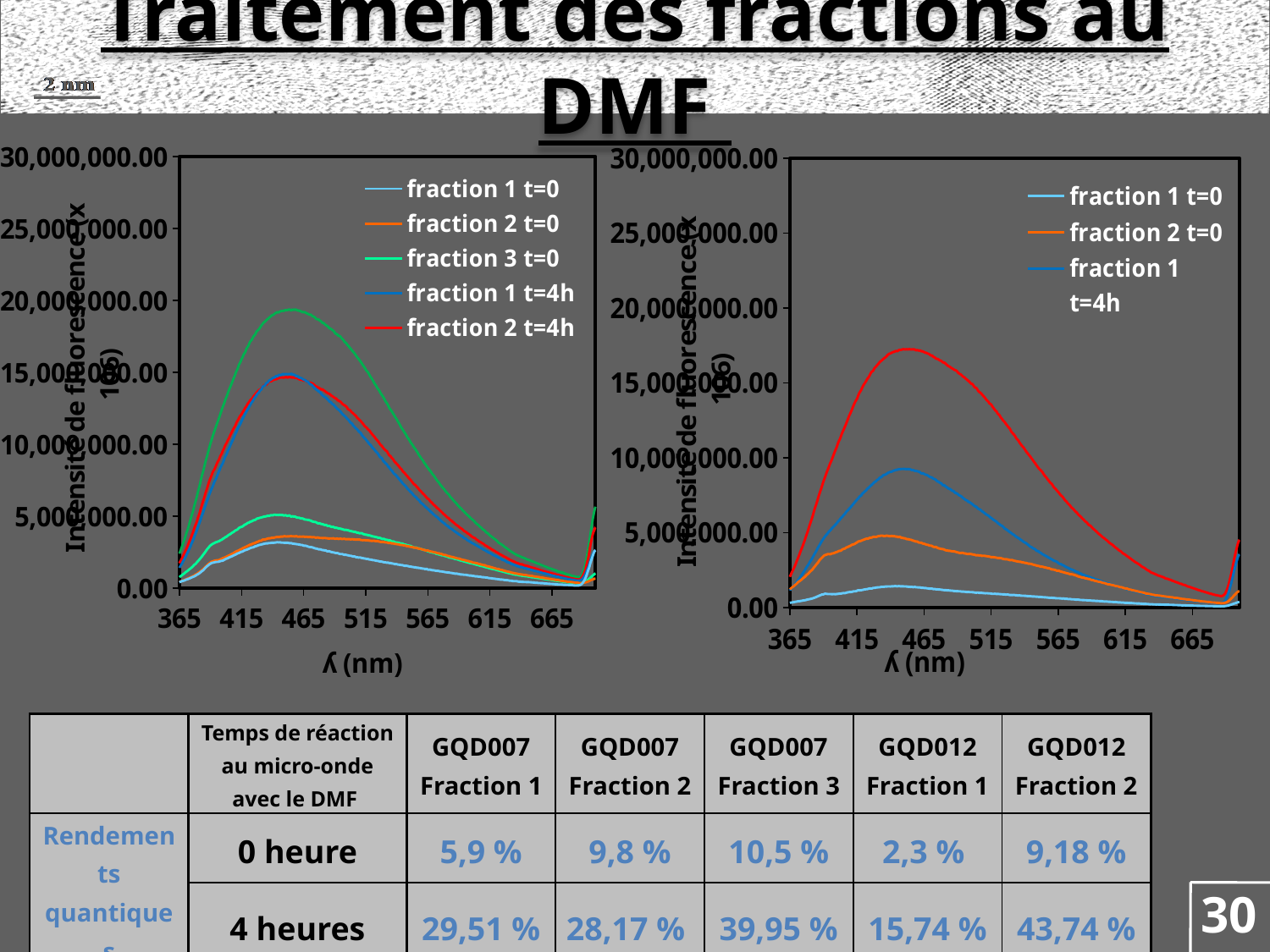
In the right chart, which of the legend series has the lowest peak intensity? fraction 1 t=0 How many series does the legend of the right chart list? 3 In the left chart, is the peak value of fraction 1 t=0 greater or less than 5,000,000.00? less In the right chart, is the peak value of fraction 1 t=4h greater or less than 10,000,000.00? less What is the x-axis label of the left chart? ʎ (nm) In the left chart, which series has the lowest peak intensity? fraction 1 t=0 What type of chart is the left chart on the slide? line chart How many series does the legend of the left chart list? 5 In the right chart, which series peaks higher: fraction 1 t=4h or fraction 2 t=0? fraction 1 t=4h